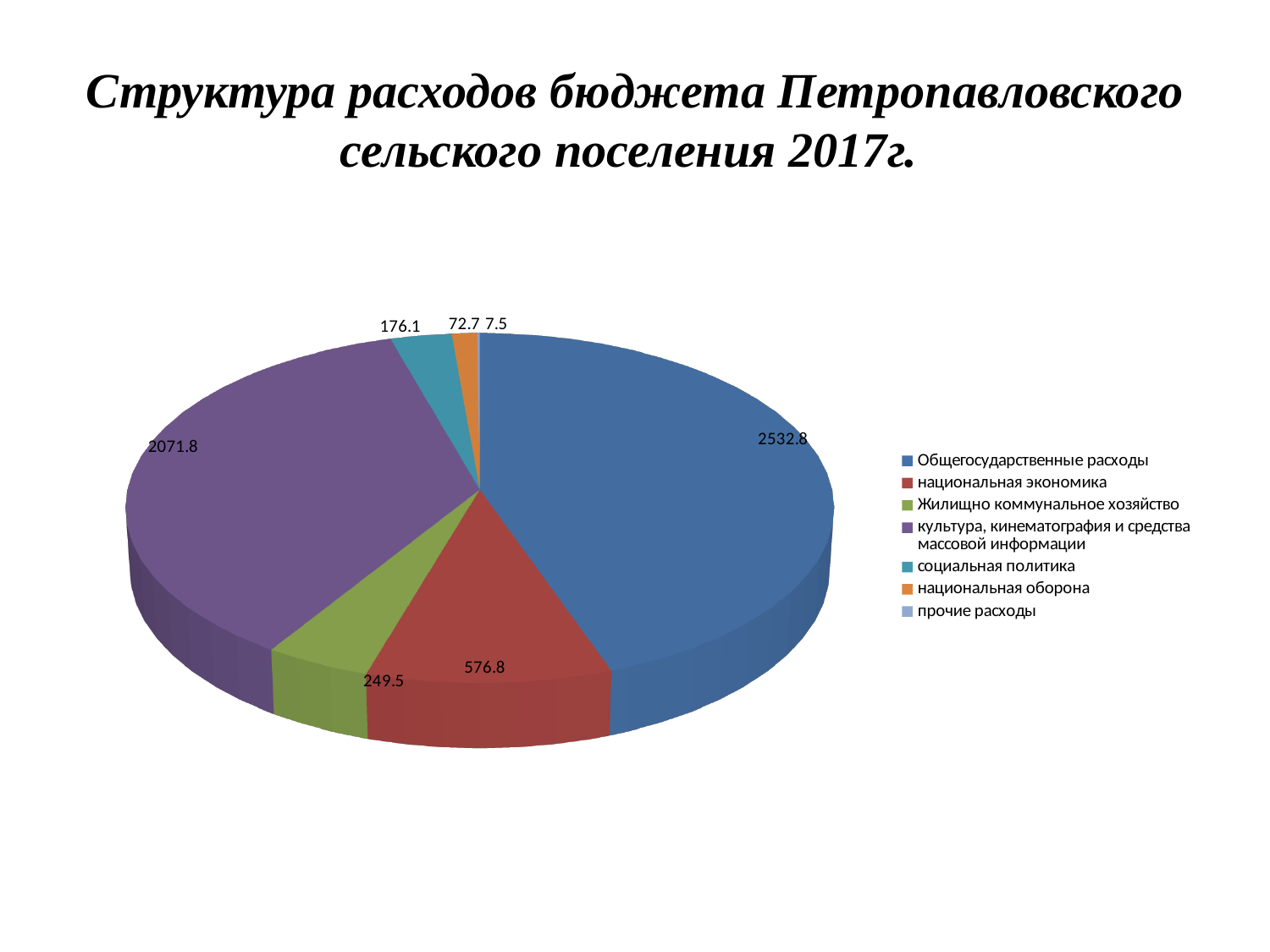
What is the value for социальная политика? 176.1 What kind of chart is shown on the slide? pie chart What is the value for Общегосударственные расходы? 2532.8 Which is larger: национальная экономика or Жилищно коммунальное хозяйство? национальная экономика What colour is the slice for национальная оборона? orange What is the value for культура, кинематография и средства массовой информации? 2071.8 What is the value for прочие расходы? 7.5 How many categories does the pie chart have? 7 Which category has the smallest slice of the pie? прочие расходы What is the value for национальная экономика? 576.8 What is the difference between the values for Общегосударственные расходы and культура, кинематография и средства массовой информации? 461 Which category has the largest slice of the pie? Общегосударственные расходы